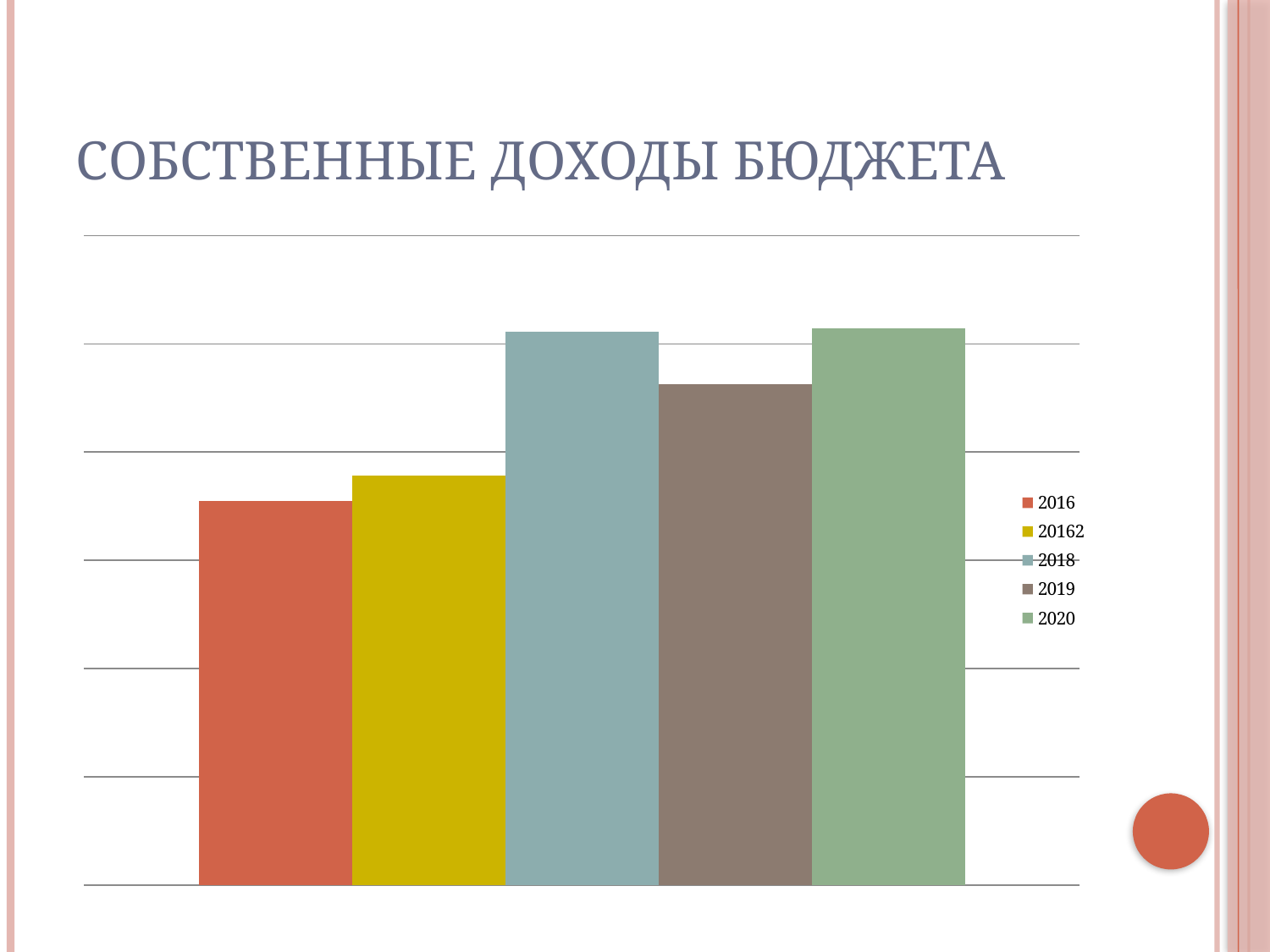
How many bars are plotted in the chart? 5 Which is larger, the bar for 20162 or the bar for 2018? 2018 Is the bar for 2019 higher or lower than the bar for 2018? lower What kind of chart is shown on the slide? bar chart What is the second entry listed in the chart legend? 20162 What is the title of the chart on the slide? СОБСТВЕННЫЕ ДОХОДЫ БЮДЖЕТА Which is larger, the bar for 2016 or the bar for 2019? 2019 Which legend entry has the lowest bar in the chart? 2016 How many entries does the chart legend list? 5